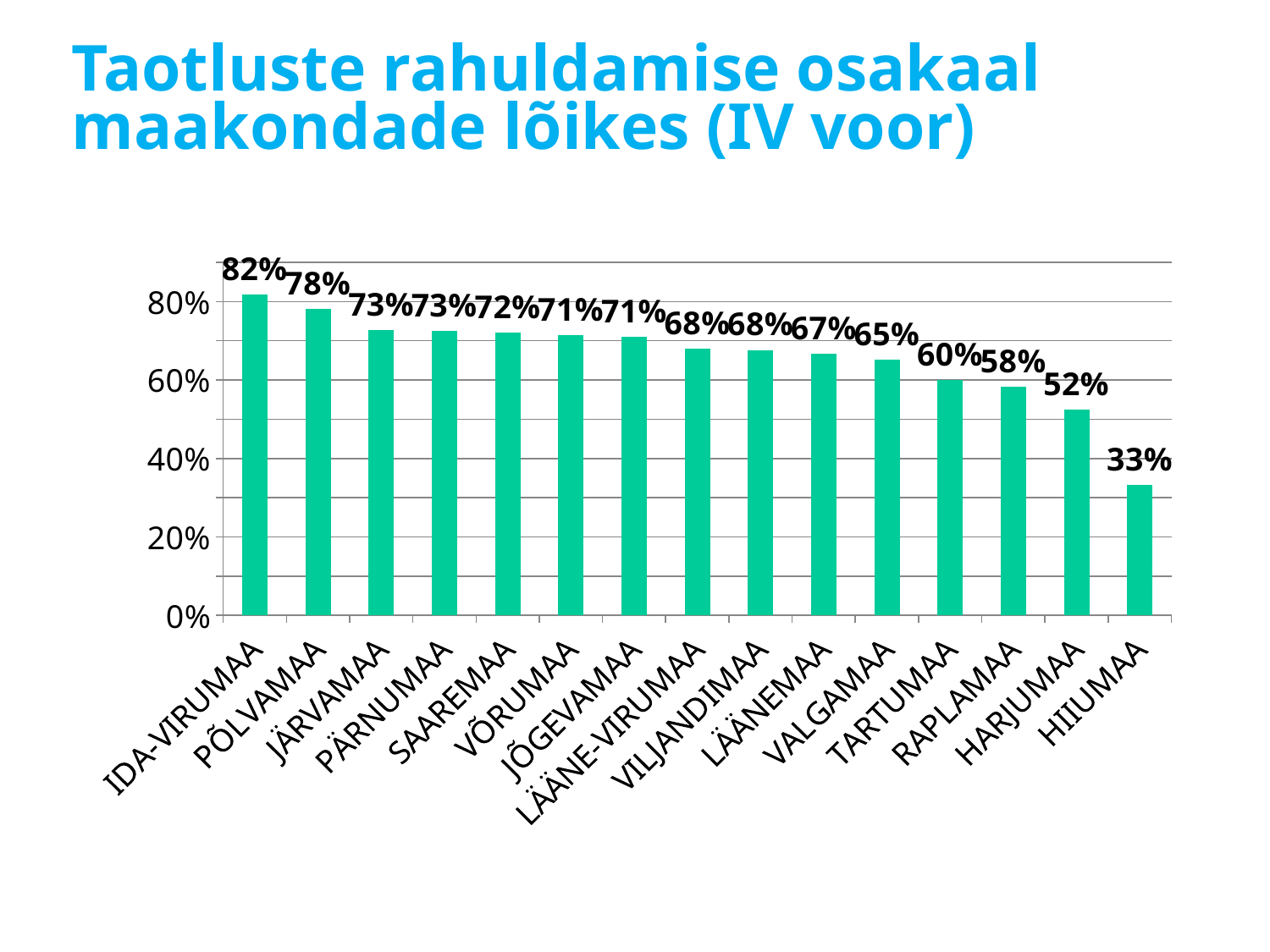
What is the difference between the values for IDA-VIRUMAA and HIIUMAA? 49% What is the value for TARTUMAA? 60% What is the value for HIIUMAA? 33% Do the values rise or fall from left to right along the x axis? fall What is the value for IDA-VIRUMAA? 82% What kind of chart is shown on the slide? bar chart Which county has the highest value? IDA-VIRUMAA What is the value for VALGAMAA? 65% What is the difference between the values for PÕLVAMAA and HARJUMAA? 26% How many counties are shown on the chart? 15 Which county has the lowest value? HIIUMAA Which is larger, the value for RAPLAMAA or the value for HARJUMAA? RAPLAMAA